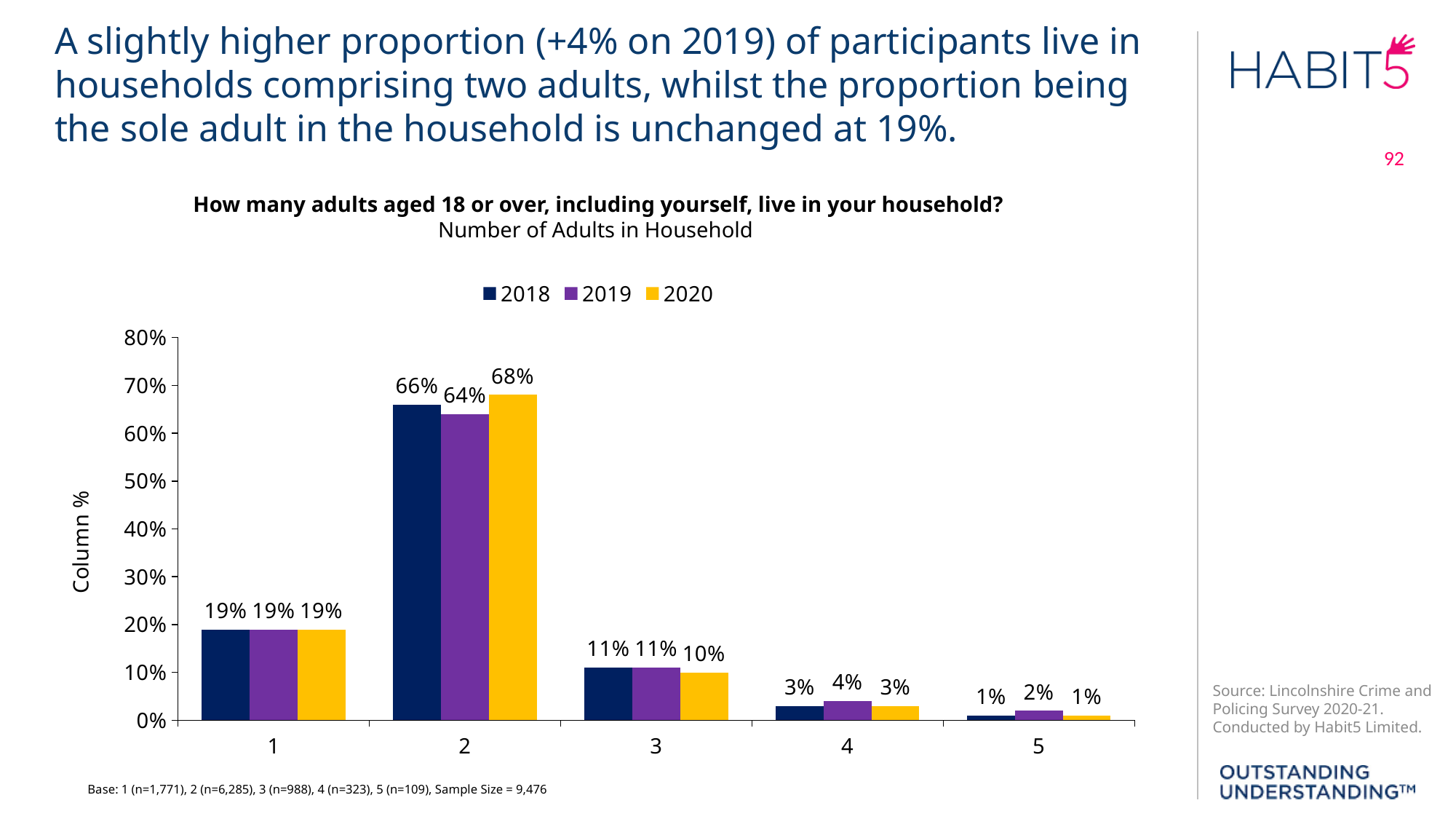
What is the 2018 value for households with 4 adults? 3% Which is larger for households with 4 adults: the 2019 value or the 2020 value? 2019 Is the 2018 value for households with 2 adults greater or less than 60%? greater How many series does the legend list? 3 What is the 2020 value for households with 2 adults? 68% What kind of chart is shown on the slide? bar chart Which number of adults in household has the highest value for 2020? 2 What is the label of the y axis? Column % What is the difference between the 2020 and 2019 values for households with 2 adults? 4% How many categories are shown on the x axis? 5 Which number of adults in household has the lowest value for 2018? 5 What is the 2019 value for households with 3 adults? 11%